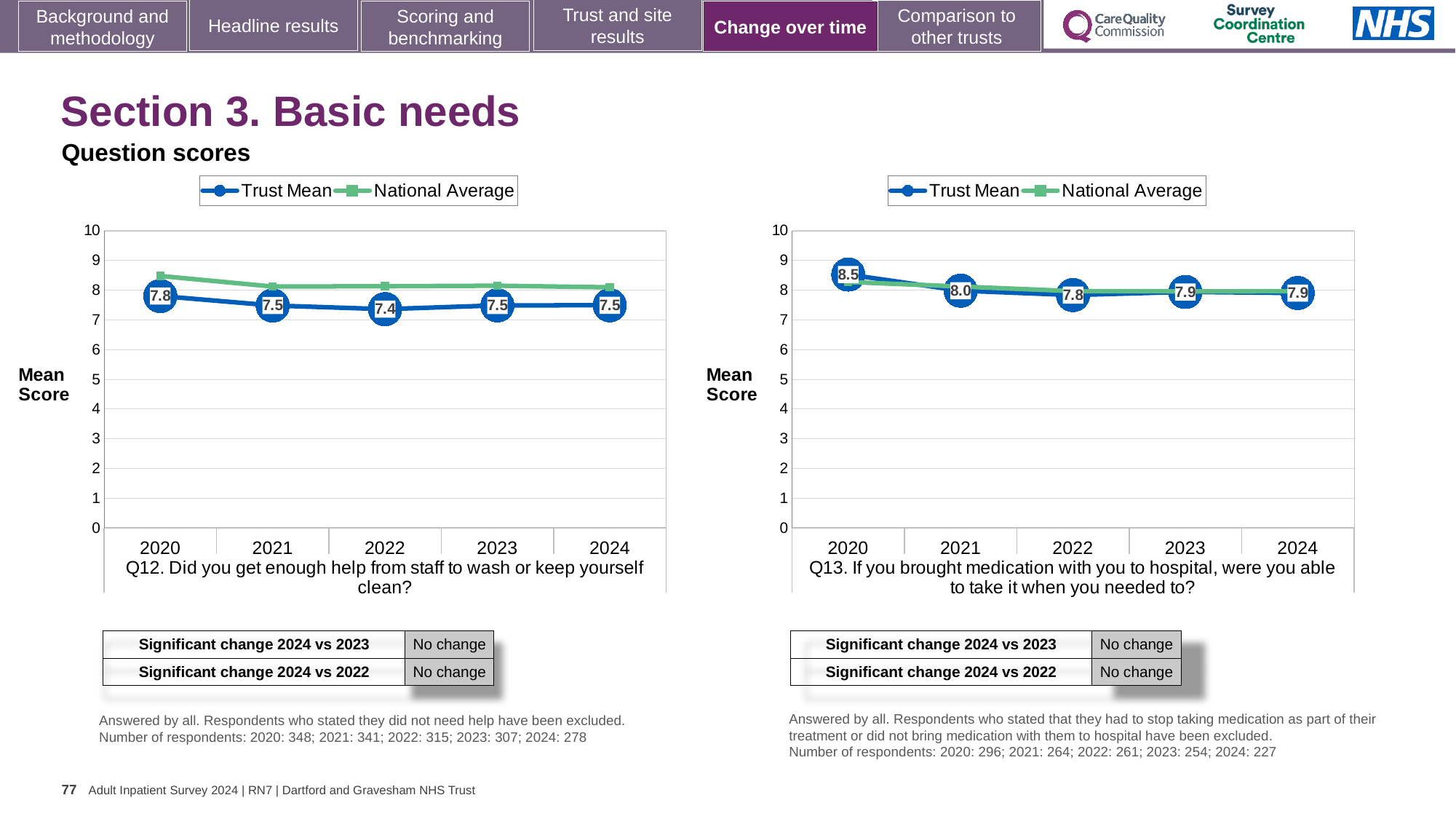
In the Q13 chart (right), what is the Trust Mean for 2020? 8.5 In the Q13 chart (right), what is the Trust Mean for 2024? 7.9 In the Q12 chart (left), which year has the lowest Trust Mean? 2022 In the Q12 chart (left), what is the Trust Mean for 2020? 7.8 In the Q13 chart (right), how many series does the legend list? 2 In the Q13 chart (right), which year has the lowest Trust Mean? 2022 In the Q12 chart (left), what is the difference between the Trust Mean for 2020 and 2024? 0.3 What kind of chart is the Q12 chart (left)? Line chart In the Q12 chart (left), which year has the highest Trust Mean? 2020 In the Q13 chart (right), what is the difference between the Trust Mean for 2020 and 2021? 0.5 In the Q12 chart (left), is the National Average for 2020 greater or less than 8? greater In the Q12 chart (left), what is the Trust Mean for 2022? 7.4